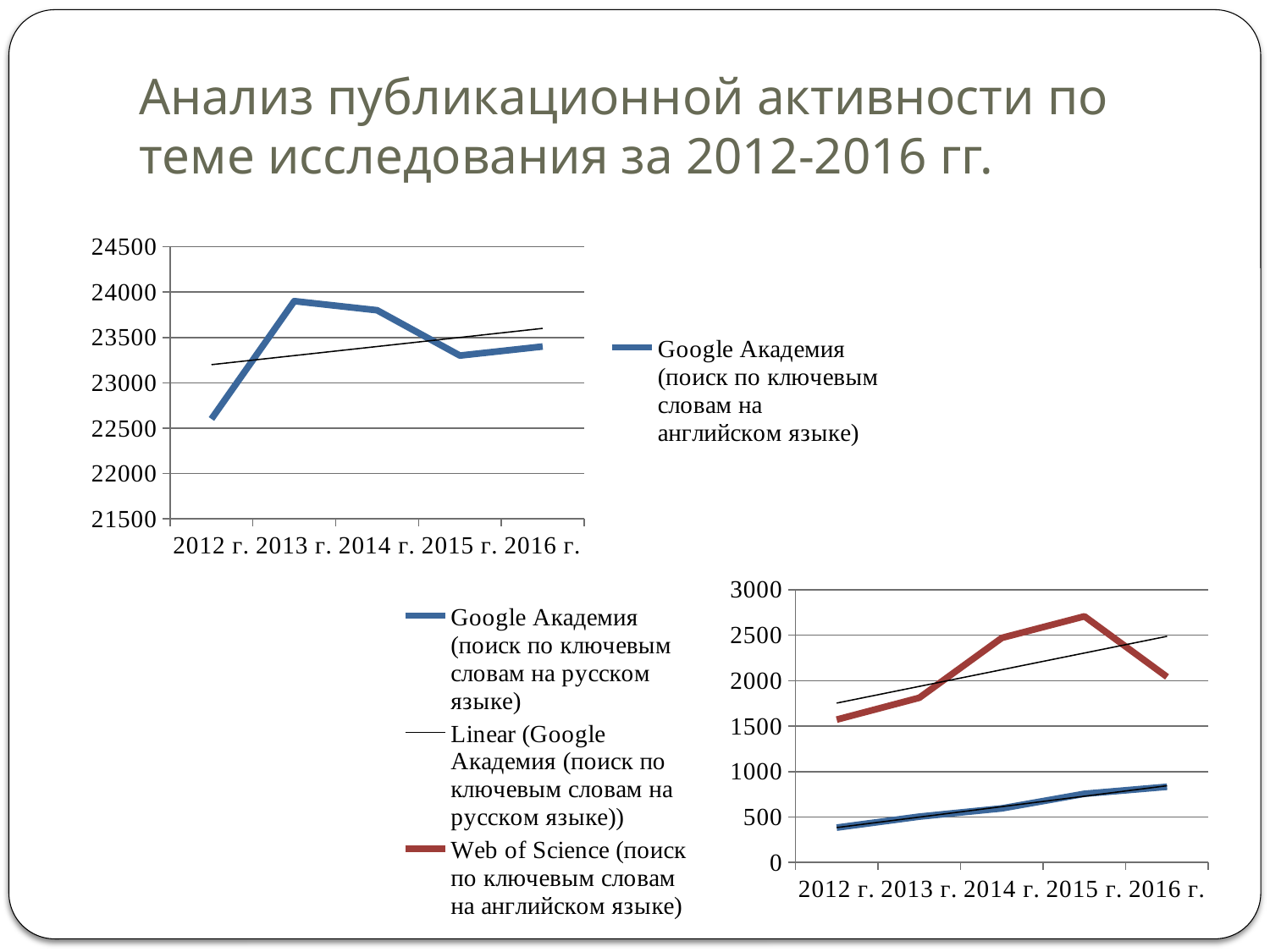
What kind of chart is the top-left chart on the slide? line chart In the top-left chart, which year has the lowest value for Google Академия (поиск по ключевым словам на английском языке)? 2012 г. In the top-left chart, is the value for 2013 г. greater or less than 23500? greater In the bottom-right chart, which year has the lowest value for Web of Science (поиск по ключевым словам на английском языке)? 2012 г. In the bottom-right chart, which year has the highest value for Web of Science (поиск по ключевым словам на английском языке)? 2015 г. How many years are plotted on the x axis of the top-left chart? 5 In the top-left chart, is the value for 2015 г. greater or less than 23500? less In the bottom-right chart, is the value for Web of Science in 2015 г. greater or less than 2500? greater In the bottom-right chart, which series has the larger value in 2016 г.: Web of Science or Google Академия (поиск по ключевым словам на русском языке)? Web of Science How many entries does the legend of the bottom-right chart list? 3 In the bottom-right chart, does the Google Академия (поиск по ключевым словам на русском языке) series rise or fall from 2012 г. to 2016 г.? rise